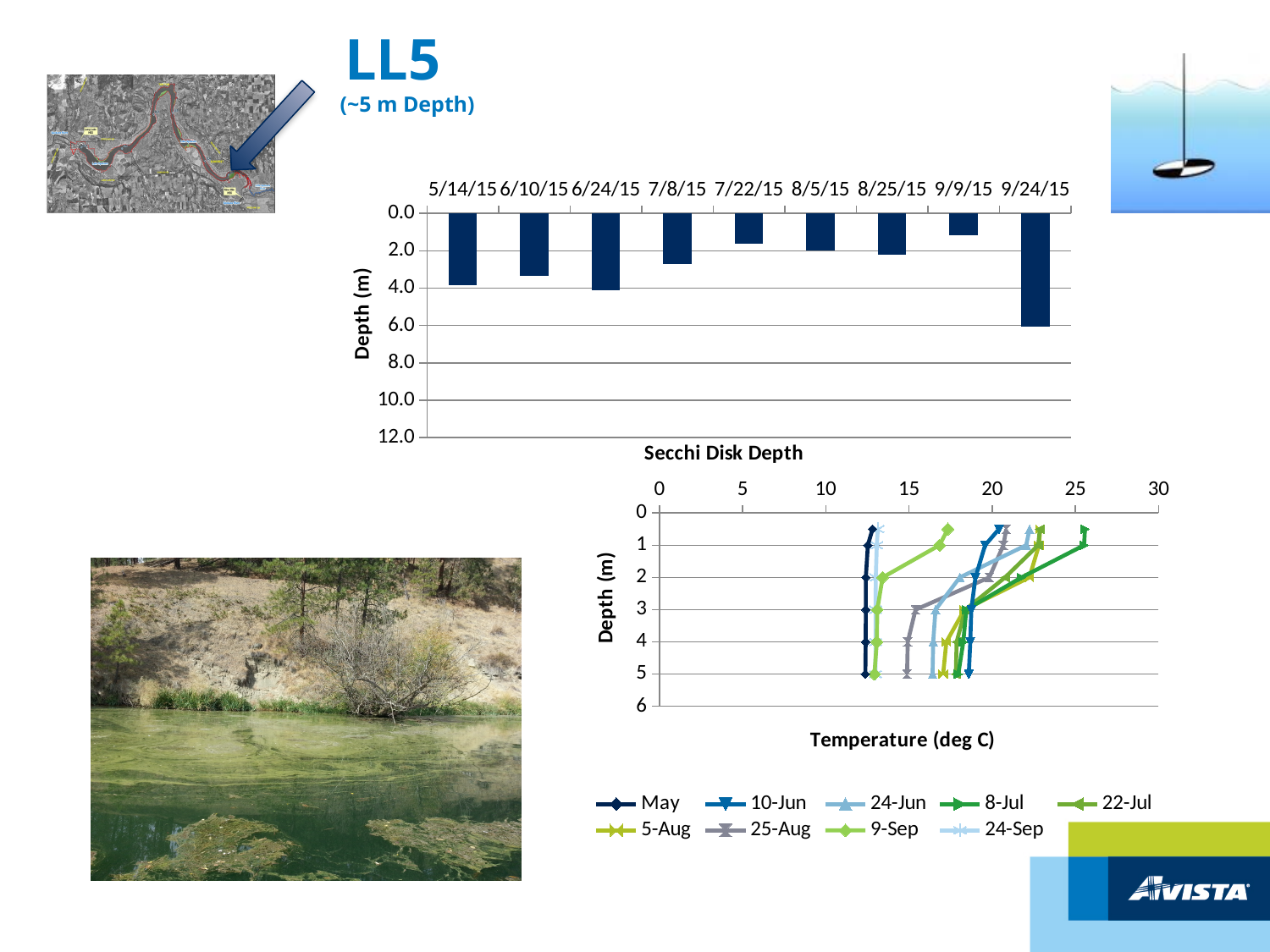
How many series does the legend of the Temperature (deg C) chart list? 9 In the Secchi Disk Depth chart, which date has a greater Secchi disk depth, 6/24/15 or 7/8/15? 6/24/15 In the Secchi Disk Depth chart, which date has the smallest Secchi disk depth (shortest bar)? 9/9/15 How many sampling dates are shown on the x axis of the Secchi Disk Depth chart? 9 In the Secchi Disk Depth chart, is the depth for 7/22/15 greater or less than 2.0 m? less In the Secchi Disk Depth chart, which date has the greatest Secchi disk depth (longest bar)? 9/24/15 In the Temperature (deg C) chart, is the 8-Jul temperature at 1 m depth greater or less than 20 deg C? greater What kind of chart is the Secchi Disk Depth chart? bar chart What kind of chart is the Temperature (deg C) chart? line chart What is the label on the vertical axis of the Secchi Disk Depth chart? Depth (m) In the Temperature (deg C) chart, is the May temperature at 5 m depth greater or less than 15 deg C? less